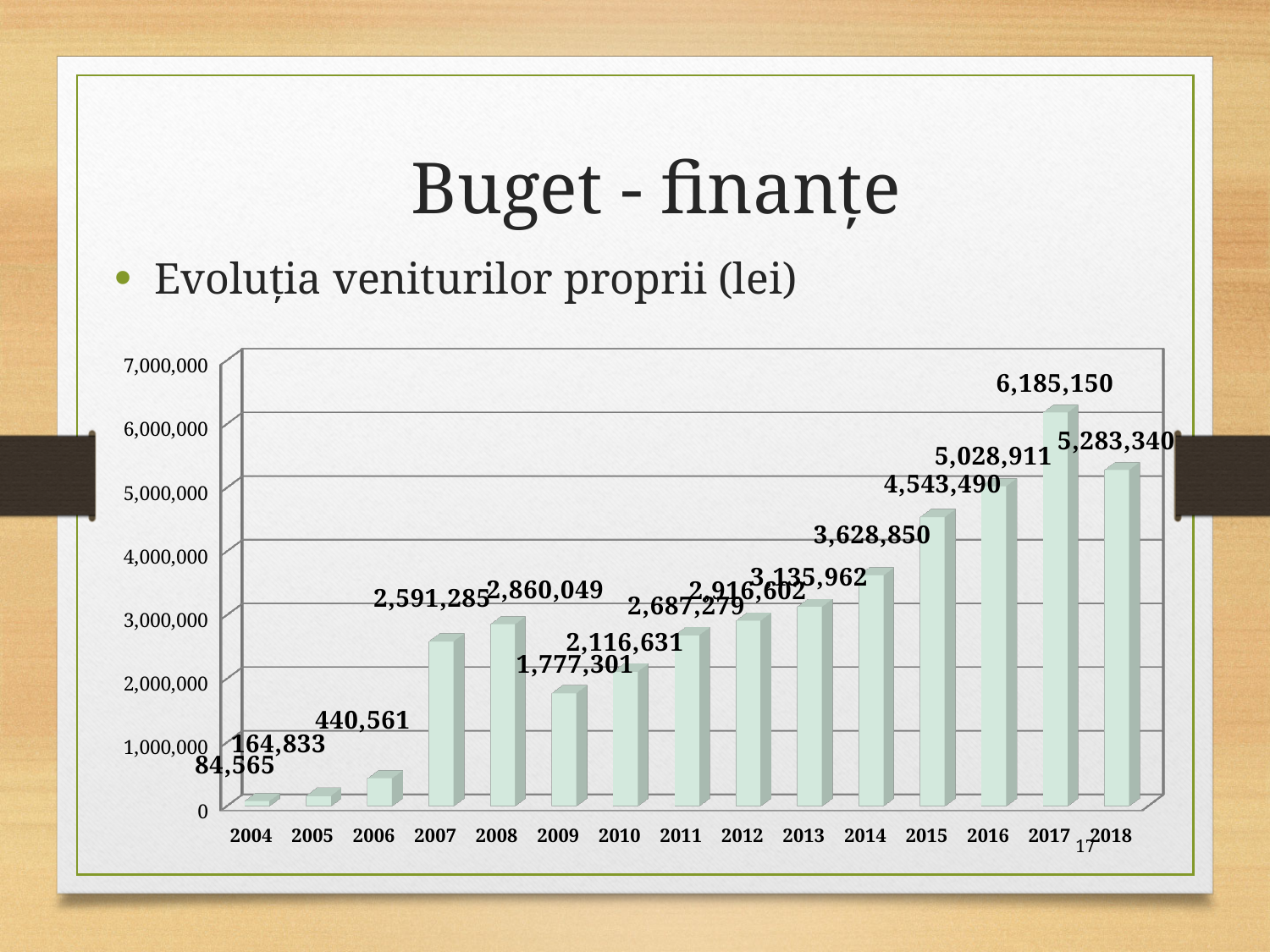
What is the value for 2004? 84,565 Do the values rise or fall from 2012 to 2017? rise Which year has the lowest value? 2004 How many years are shown on the x axis? 15 Is the value for 2015 greater or less than 4,000,000? greater Which year has the highest value? 2017 What is the difference between the values for 2017 and 2018? 901,810 What is the difference between the values for 2008 and 2007? 268,764 Which is larger, the value for 2009 or the value for 2010? 2010 What kind of chart is shown on the slide? bar chart What is the value for 2017? 6,185,150 What is the value for 2009? 1,777,301